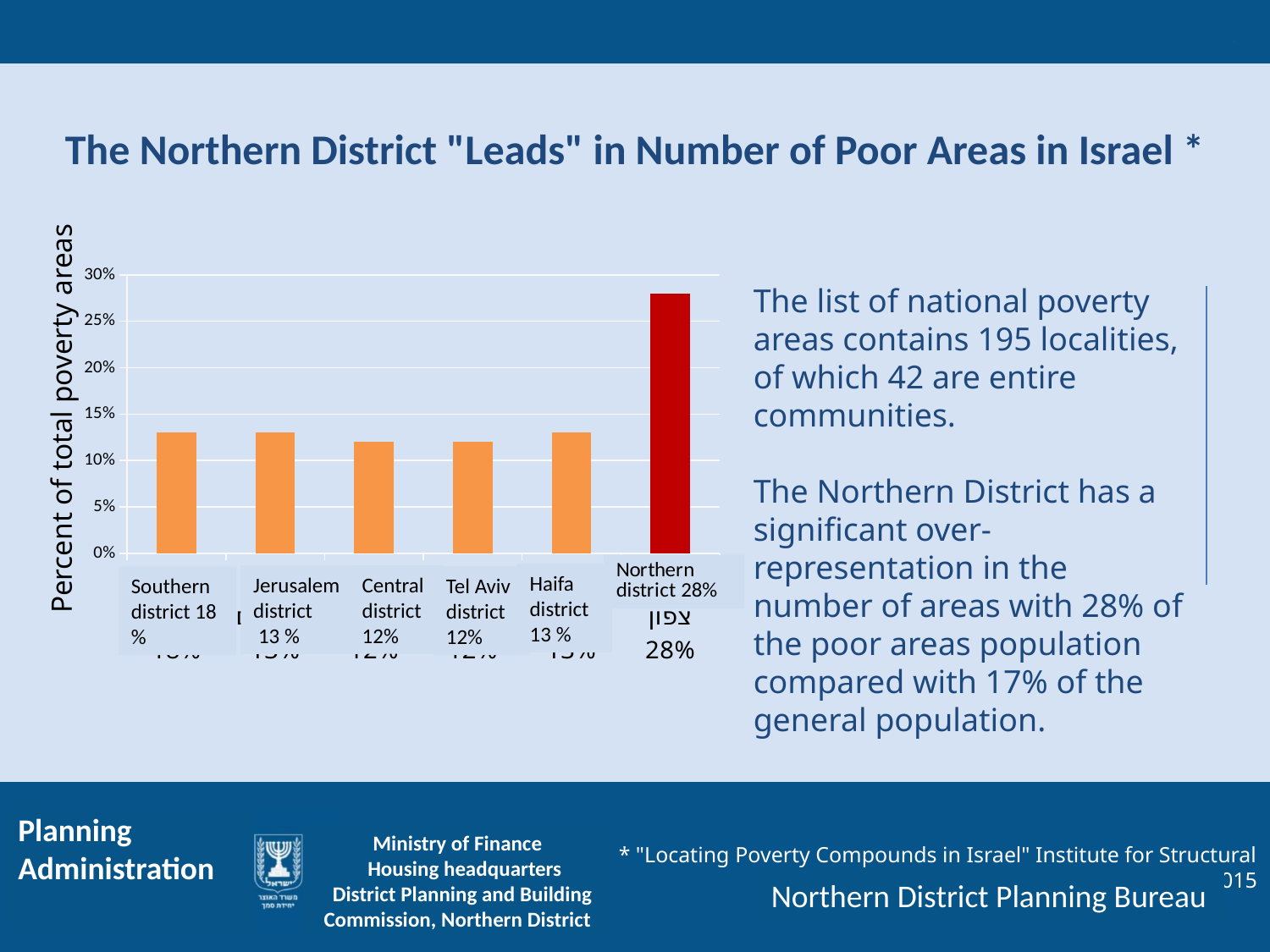
What is the value shown for the Tel Aviv district? 12% Which district has the highest percent of total poverty areas? Northern district What kind of chart is shown on the slide? Bar chart Which has a larger value, the Northern district or the Haifa district? Northern district What is the value shown for the Northern district? 28% Is the value for the Northern district greater or less than 25%? greater What is the title of the vertical axis of the chart? Percent of total poverty areas How many districts are plotted in the chart? 6 What is the value shown for the Central district? 12% What is the difference between the Northern district's value and the Central district's value? 16 percentage points What is the value shown for the Jerusalem district? 13 % What is the value shown for the Haifa district? 13 %